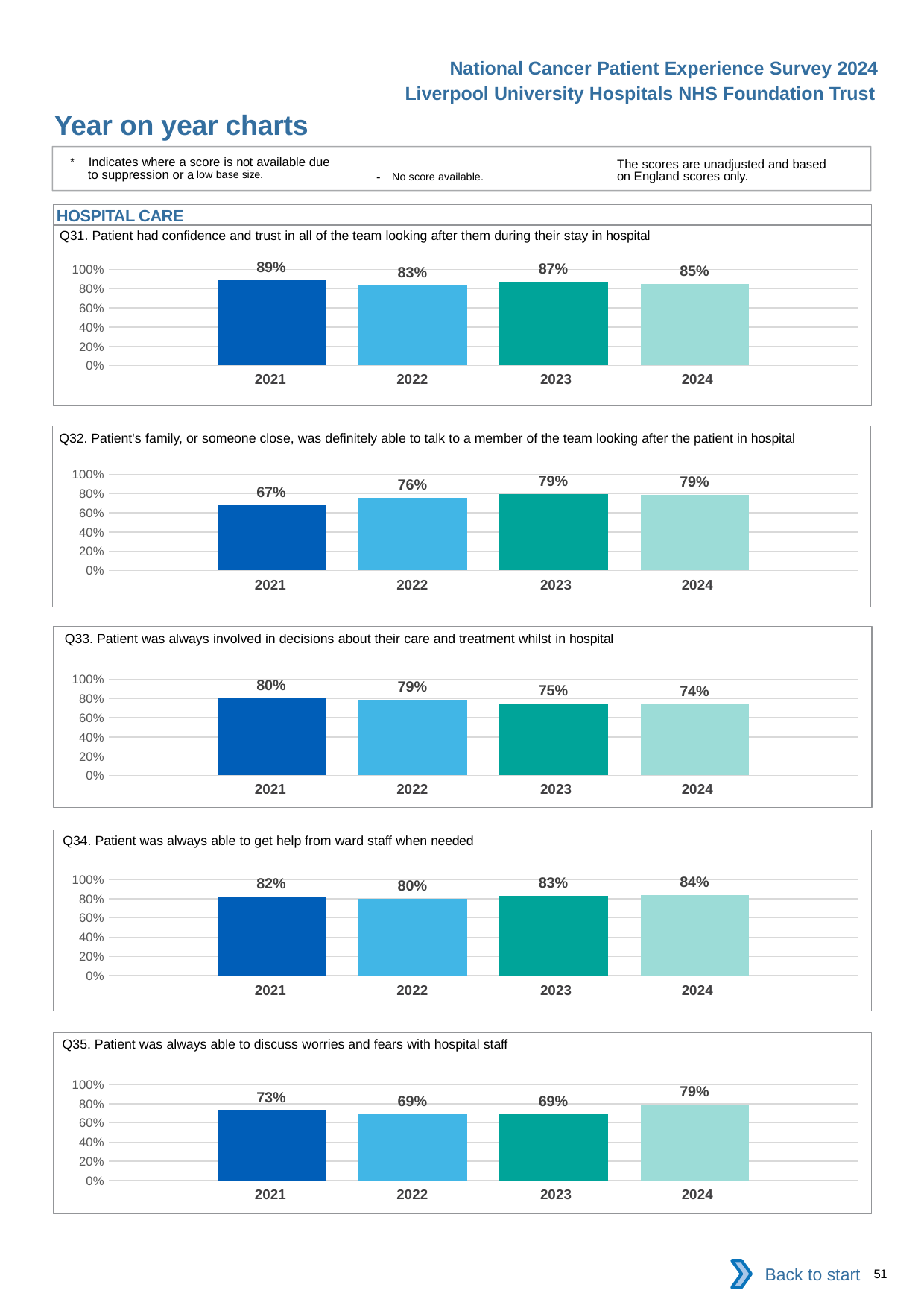
How many years are shown in the Q32 chart (patient's family was definitely able to talk to a member of the team)? 4 In the Q33 chart (patient was always involved in decisions about their care), what is the difference between the 2021 and 2024 values? 6 percentage points In the Q31 chart (patient had confidence and trust in all of the team), which is larger, the 2022 value or the 2023 value? 2023 What kind of chart is the Q34 chart (patient was always able to get help from ward staff)? bar chart How many charts are shown on the slide under the HOSPITAL CARE heading? 5 In the Q35 chart (patient was always able to discuss worries and fears), what is the difference between the 2024 and 2023 values? 10 percentage points In the Q32 chart (patient's family was definitely able to talk to a member of the team), what is the value for 2022? 76% In the Q33 chart (patient was always involved in decisions about their care), do the values rise or fall from 2021 to 2024? fall In the Q34 chart (patient was always able to get help from ward staff), which year has the highest value? 2024 In the Q31 chart (patient had confidence and trust in all of the team), what is the value for 2021? 89% In the Q35 chart (patient was always able to discuss worries and fears), what is the value for 2024? 79% In the Q32 chart (patient's family was definitely able to talk to a member of the team), which year has the lowest value? 2021